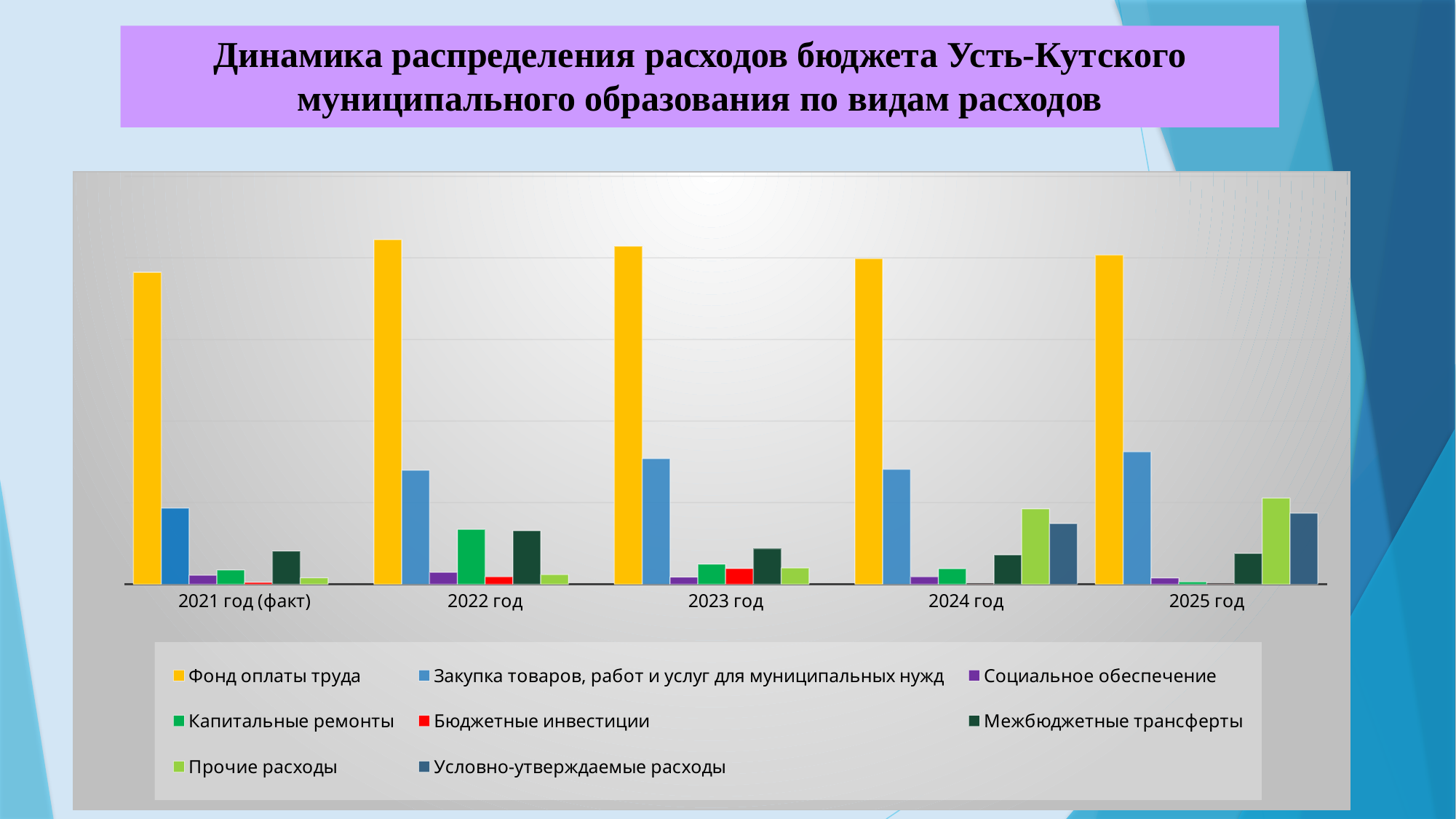
In 2023 год, which is larger: Закупка товаров, работ и услуг для муниципальных нужд or Межбюджетные трансферты? Закупка товаров, работ и услуг для муниципальных нужд Which series has the second-tallest bar in 2023 год? Закупка товаров, работ и услуг для муниципальных нужд How many series does the chart legend list? 8 Which series has the tallest bar in every year shown? Фонд оплаты труда What is the title of the slide's chart? Динамика распределения расходов бюджета Усть-Кутского муниципального образования по видам расходов In which year is the Фонд оплаты труда bar the lowest? 2021 год (факт) What kind of chart is shown on the slide? Bar chart In 2021 год (факт), which is larger: Закупка товаров, работ и услуг для муниципальных нужд or Социальное обеспечение? Закупка товаров, работ и услуг для муниципальных нужд Which is larger: Капитальные ремонты in 2022 год or Капитальные ремонты in 2025 год? 2022 год How many year categories are shown on the x axis of the chart? 5 In which year is the Закупка товаров, работ и услуг для муниципальных нужд bar the lowest? 2021 год (факт) What colour represents Фонд оплаты труда in the chart legend? Yellow